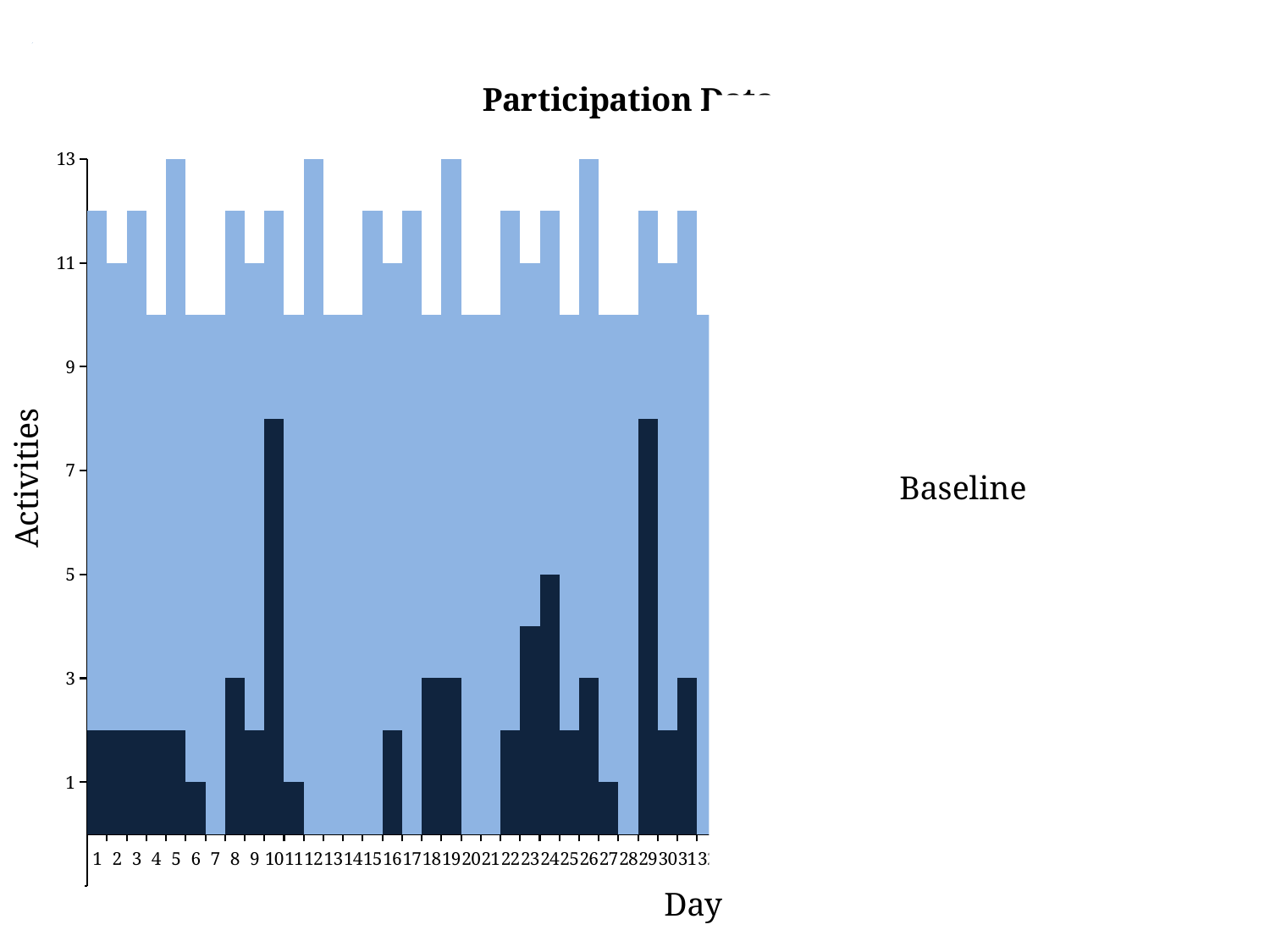
Is the value of the dark navy bar for day 10 greater or less than 7? greater What is the title of the vertical axis? Activities Which is larger, the dark navy bar for day 24 or the dark navy bar for day 8? day 24 What is the value of the dark navy bar for day 8? 3 What is the title of the horizontal axis? Day What kind of chart is shown on the slide? bar chart What is the value of the dark navy bar for day 24? 5 What is the difference between the light blue bar for day 5 and the light blue bar for day 2? 2 What is the value of the dark navy bar for day 6? 1